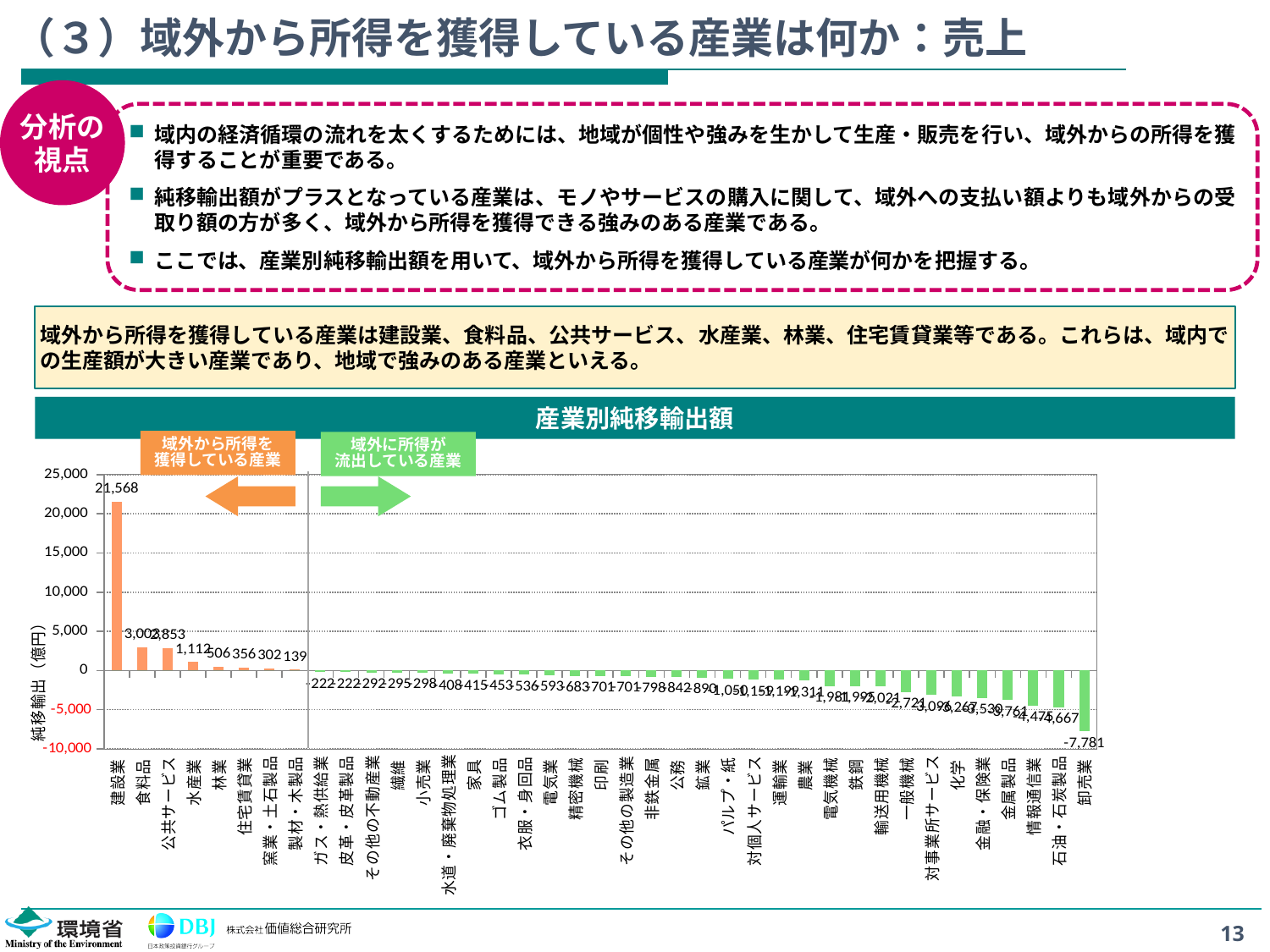
What is the value for 建設業 in the 産業別純移輸出額 chart? 21,568 What is the value for 卸売業 in the 産業別純移輸出額 chart? -7,781 What is the value for 食料品 in the 産業別純移輸出額 chart? 3,003 Which has the larger value in the 産業別純移輸出額 chart, 食料品 or 公共サービス? 食料品 How many industries are shown on the x axis of the 産業別純移輸出額 chart? 39 Which industry has the highest value in the 産業別純移輸出額 chart? 建設業 Which industry has the lowest value in the 産業別純移輸出額 chart? 卸売業 Do the values in the 産業別純移輸出額 chart rise or fall from left to right along the x axis? fall What kind of chart is the 産業別純移輸出額 chart? bar chart What is the difference between the values for 建設業 and 食料品 in the 産業別純移輸出額 chart? 18,565 Is the value for 石油・石炭製品 in the 産業別純移輸出額 chart greater or less than -5,000? greater What is the value for 水産業 in the 産業別純移輸出額 chart? 1,112